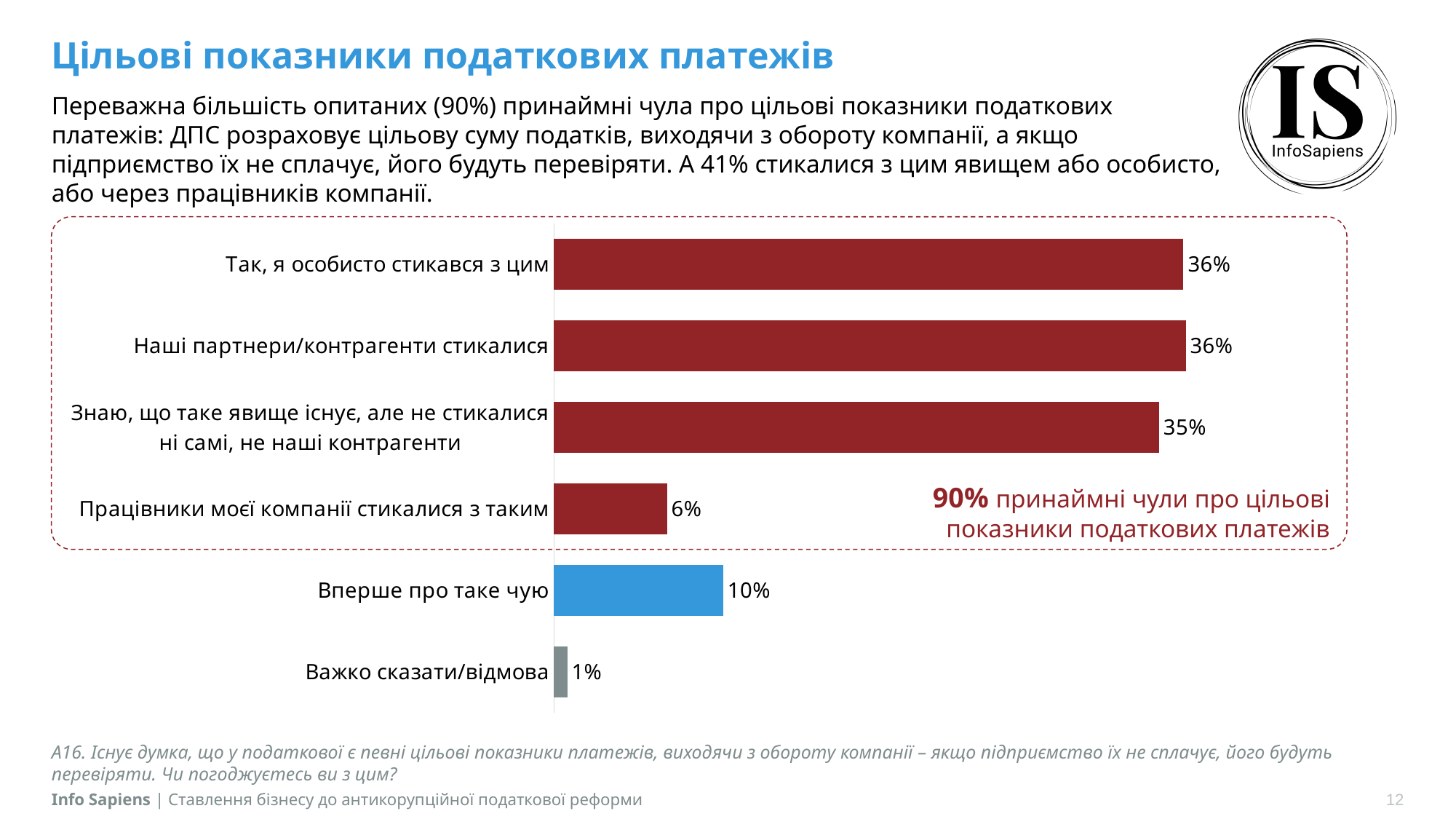
What is the difference between the values for "Вперше про таке чую" and "Працівники моєї компанії стикалися з таким"? 4 percentage points According to the annotation inside the dashed box, what share of respondents had at least heard about target tax payment indicators? 90% What value is shown for "Наші партнери/контрагенти стикалися"? 36% What percentage is shown for "Знаю, що таке явище існує, але не стикалися ні самі, не наші контрагенти"? 35% Which is larger: the value for "Вперше про таке чую" or for "Працівники моєї компанії стикалися з таким"? Вперше про таке чую What percentage of respondents answered "Так, я особисто стикався з цим"? 36% What value is shown for "Працівники моєї компанії стикалися з таким"? 6% What type of chart is shown on the slide? Bar chart Which category has the lowest value in the chart? Важко сказати/відмова What percentage of respondents answered "Вперше про таке чую"? 10% How many categories are shown in the chart? 6 What is the difference between the values for "Так, я особисто стикався з цим" and "Важко сказати/відмова"? 35 percentage points